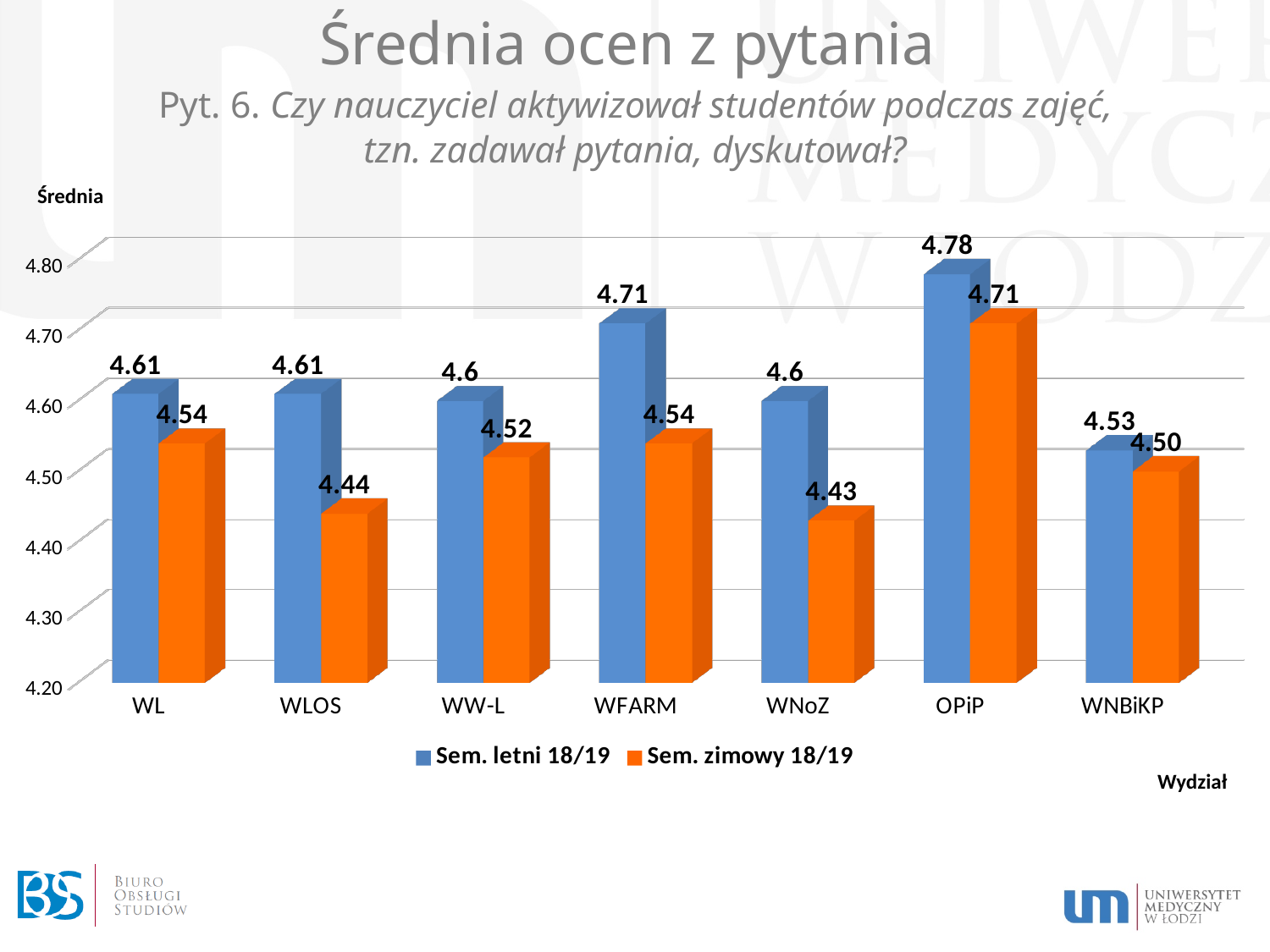
What is the value for WLOS in the Sem. zimowy 18/19 series? 4.44 How many faculties are shown on the x axis? 7 What is the value for OPiP in the Sem. letni 18/19 series? 4.78 What kind of chart is shown on the slide? bar chart What is the value for WNoZ in the Sem. zimowy 18/19 series? 4.43 What is the difference between the Sem. letni 18/19 and Sem. zimowy 18/19 values for WLOS? 0.17 How many series does the legend list? 2 Which faculty has the highest value in the Sem. letni 18/19 series? OPiP Which colour represents the Sem. zimowy 18/19 series? orange Which faculty has the lowest value in the Sem. letni 18/19 series? WNBiKP Which is larger for WFARM: the Sem. letni 18/19 value or the Sem. zimowy 18/19 value? Sem. letni 18/19 Which faculty has the lowest value in the Sem. zimowy 18/19 series? WNoZ